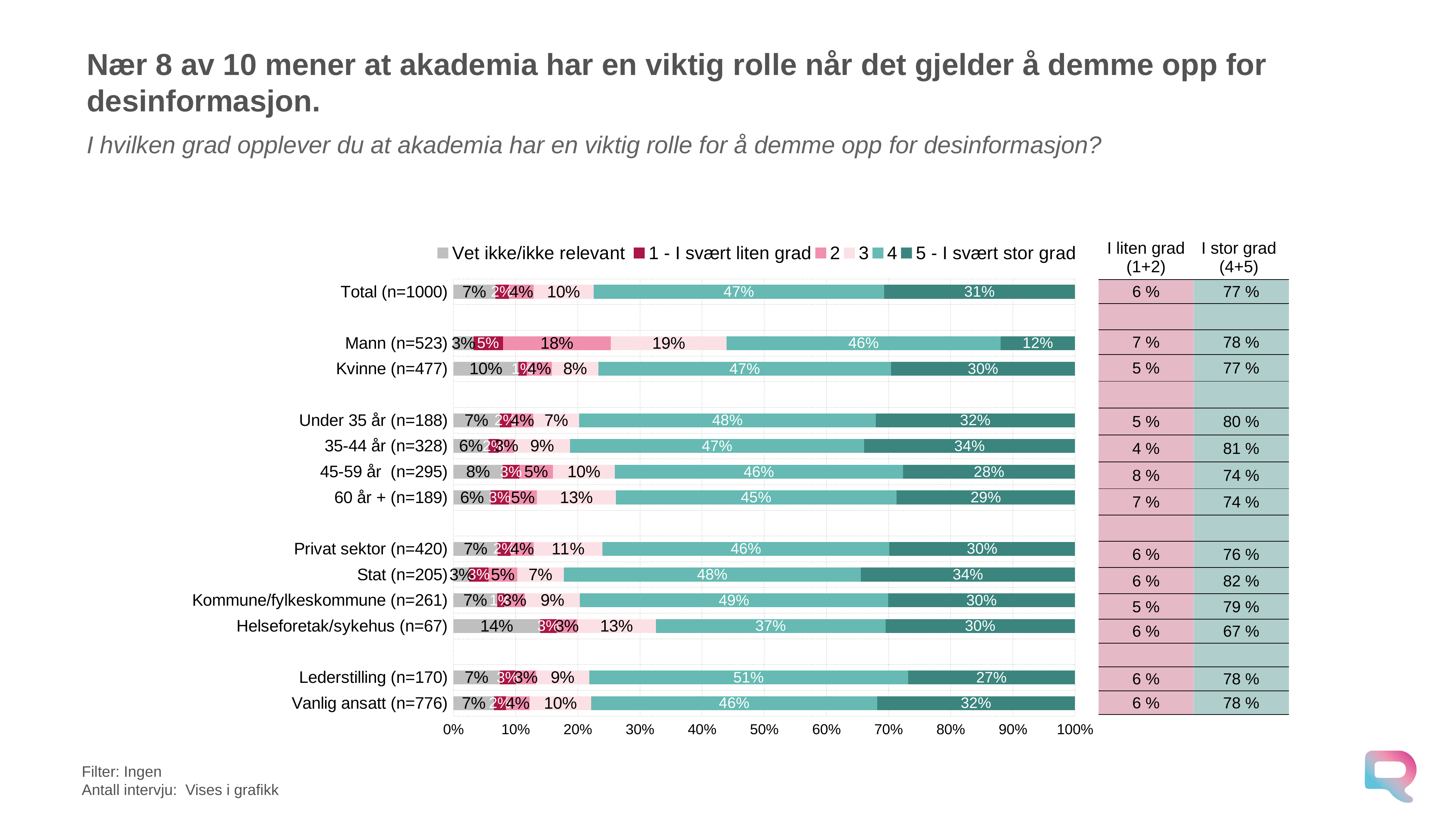
What is the value of the '5 - I svært stor grad' segment for Total (n=1000)? 31% How many categories (rows) are plotted in the chart? 13 Which category has the lowest value for the '4' segment? Helseforetak/sykehus (n=67) What is the value of the '4' segment for Total (n=1000)? 47% How many series does the chart legend list? 6 What is the value of the '3' segment for 60 år + (n=189)? 13% What kind of chart is shown on the slide? Stacked bar chart Which has a larger '5 - I svært stor grad' value: Under 35 år (n=188) or 45-59 år (n=295)? Under 35 år (n=188) For Total (n=1000), what is the difference between the '4' segment and the '5 - I svært stor grad' segment? 16 percentage points Which category has the highest value for the '4' segment? Lederstilling (n=170) What is the 'Vet ikke/ikke relevant' value for Helseforetak/sykehus (n=67)? 14% In the 'I stor grad (4+5)' column, what is the value for Stat (n=205)? 82 %